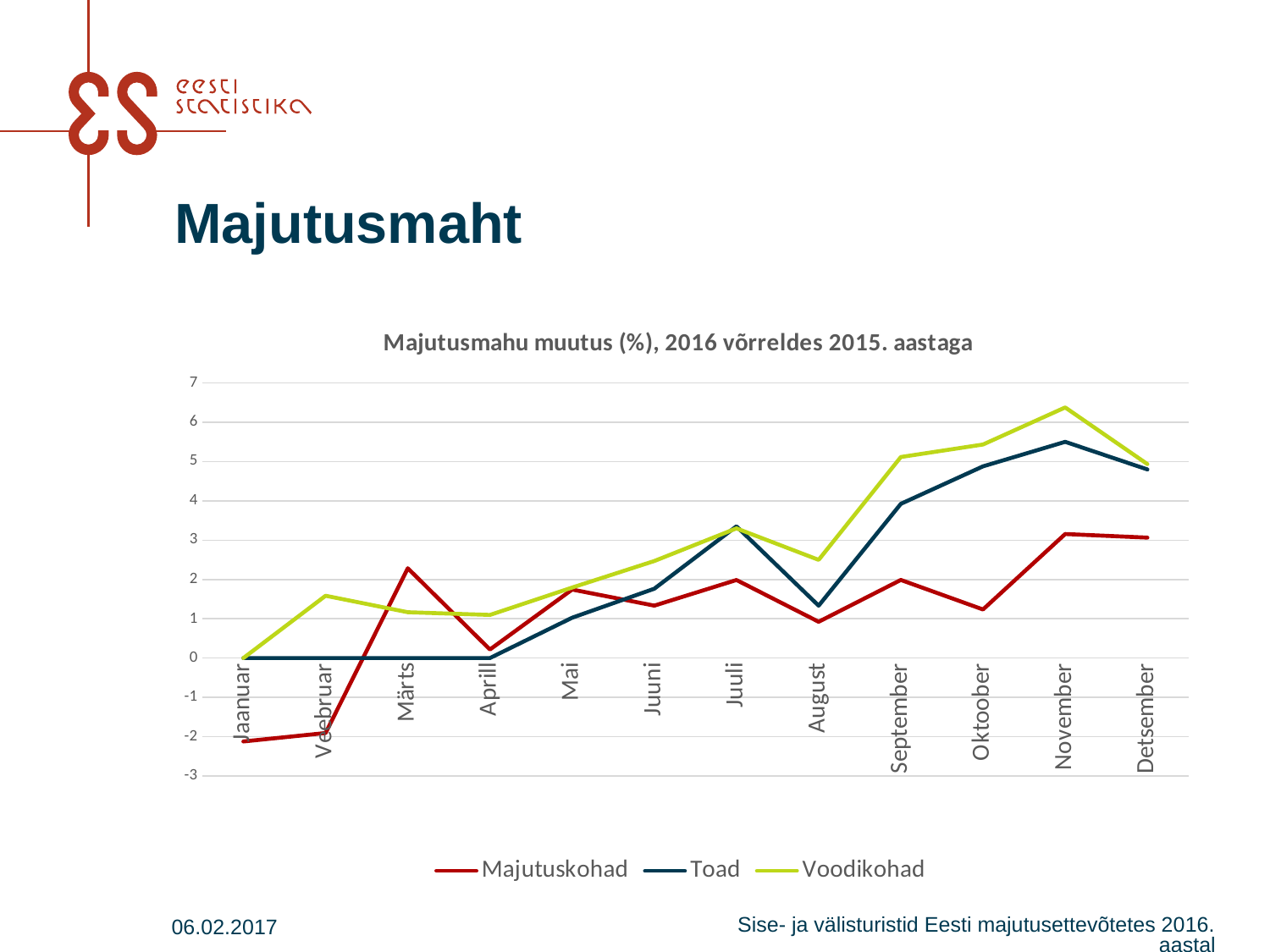
What kind of chart is shown on the slide? line chart In which month does the Voodikohad series reach its highest value? November Is the value for Voodikohad in November greater or less than 6? greater Does the Toad series rise or fall from August to November? rise In November, which series has the larger value, Voodikohad or Majutuskohad? Voodikohad Is the value for Toad in Juuni greater or less than 1? greater In which month is the Majutuskohad series at its lowest value? Jaanuar Is the value for Voodikohad in August greater or less than 2? greater How many series does the legend list? 3 What is the value of the Toad series in Jaanuar? 0 What is the title of the chart? Majutusmahu muutus (%), 2016 võrreldes 2015. aastaga How many months are shown on the x axis? 12